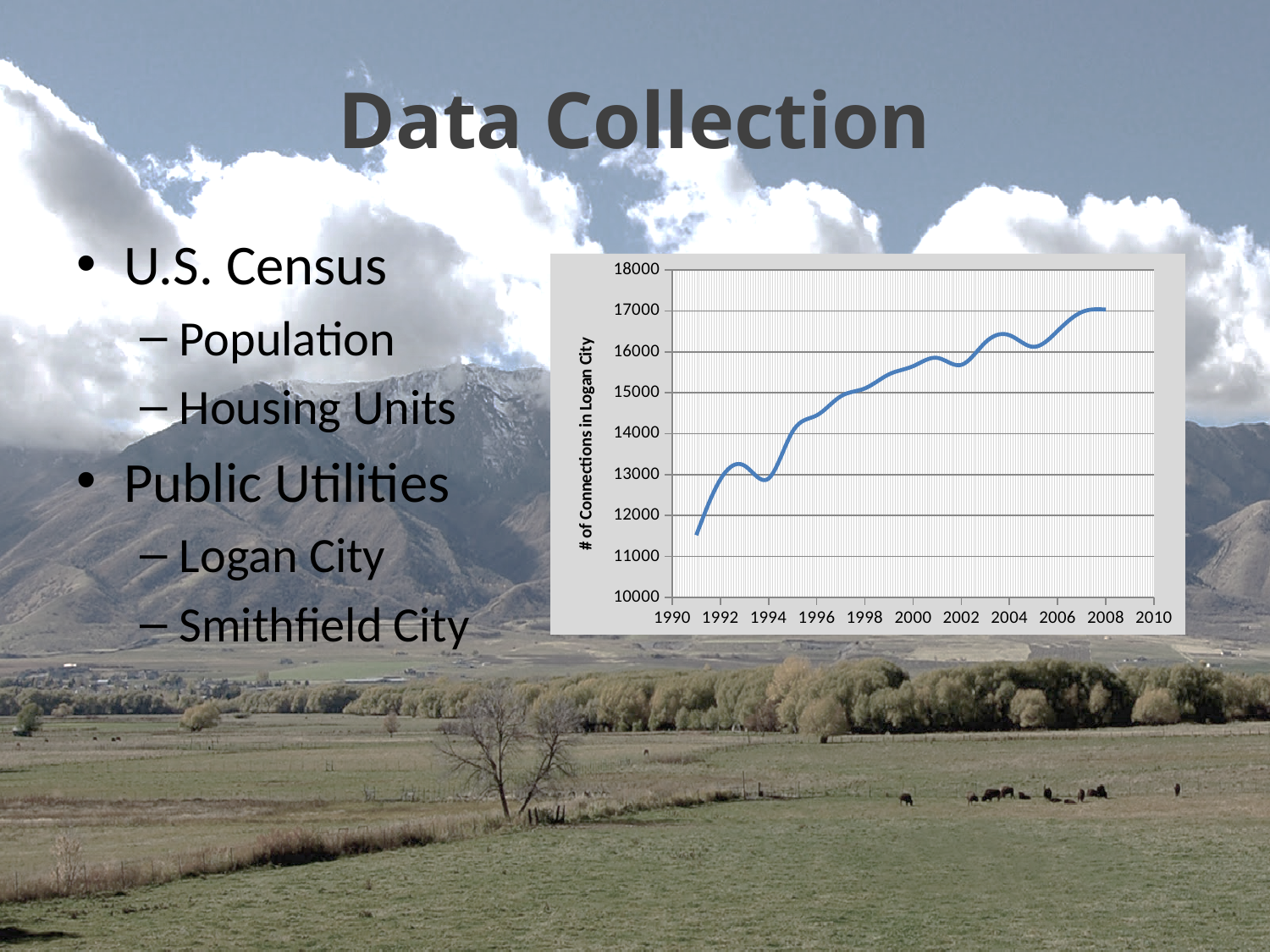
What is the label on the vertical axis of the chart? # of Connections in Logan City What is the highest value shown on the vertical axis of the chart? 18000 In which year does the line have its lowest value? 1991 Is the value for 2000 greater or less than 15000? greater Which year has the larger value, 1996 or 2000? 2000 What kind of chart is shown on the slide? line chart In which year does the line reach its highest value? 2008 Is the value for 1998 greater or less than 16000? less Is the value for 1991 greater or less than 12000? less Overall, do the values in the chart rise or fall from 1990 to 2008? rise